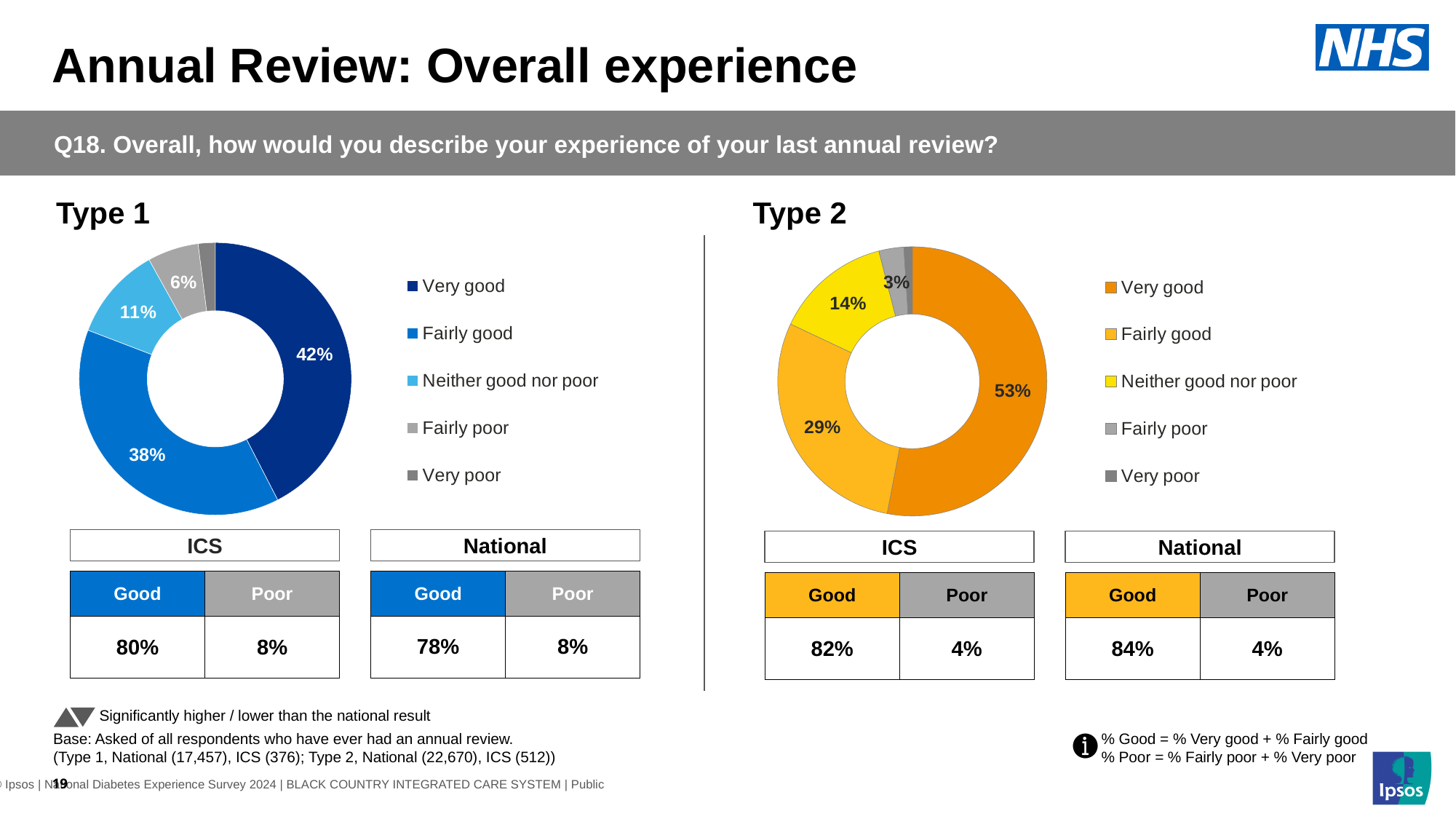
Which is larger: the Very good share in the Type 1 chart or the Very good share in the Type 2 chart? Type 2 What kind of chart is used to show the Type 2 results? Pie (donut) chart In the Type 1 chart, which response category has the smallest share? Very poor In the Type 2 chart, what percentage of respondents said Fairly poor? 3% In the Type 1 chart, what is the difference in percentage points between Very good and Fairly good? 4 percentage points In the Type 1 chart, what percentage of respondents said Neither good nor poor? 11% In the Type 2 chart, what percentage of respondents said their experience was Fairly good? 29% In the Type 1 chart, what percentage of respondents said their experience was Very good? 42% How many response categories does the legend of the Type 1 chart list? 5 In the Type 2 chart, which response category has the largest share? Very good In the Type 2 chart, what is the difference in percentage points between Very good and Fairly good? 24 percentage points In the Type 2 chart, what colour represents Neither good nor poor? Yellow